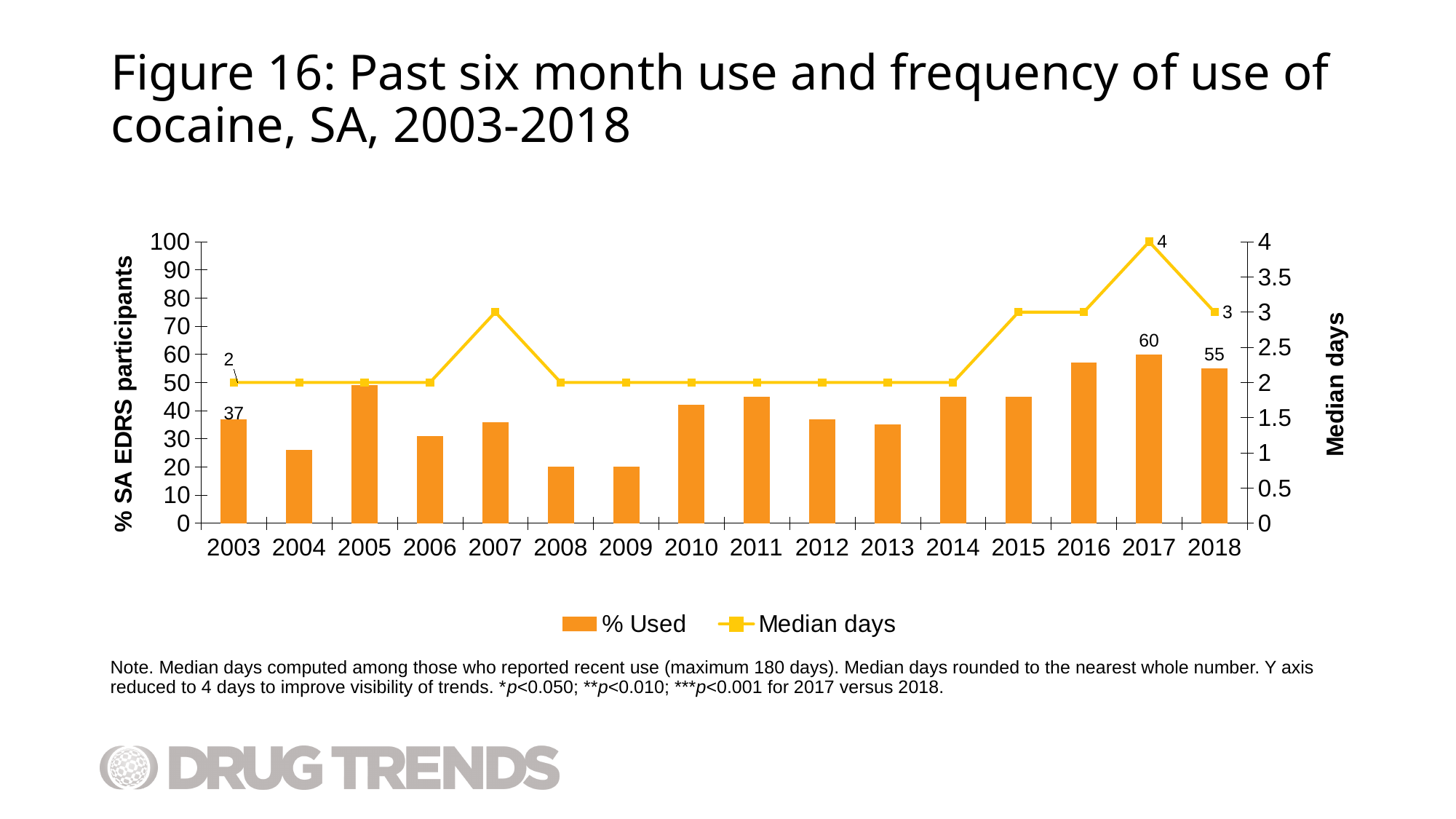
What is the % Used value for 2003? 37 What is the Median days value for 2018? 3 Is the % Used value for 2004 greater or less than 30? less How many series does the legend list? 2 How many years are shown on the x axis? 16 Which year has a higher % Used, 2017 or 2018? 2017 What is the % Used value for 2017? 60 Is the % Used value for 2016 greater or less than 50? greater Which year has the highest % Used? 2017 What is the difference in % Used between 2017 and 2018? 5 What is the Median days value for 2017? 4 Which year has the highest Median days? 2017